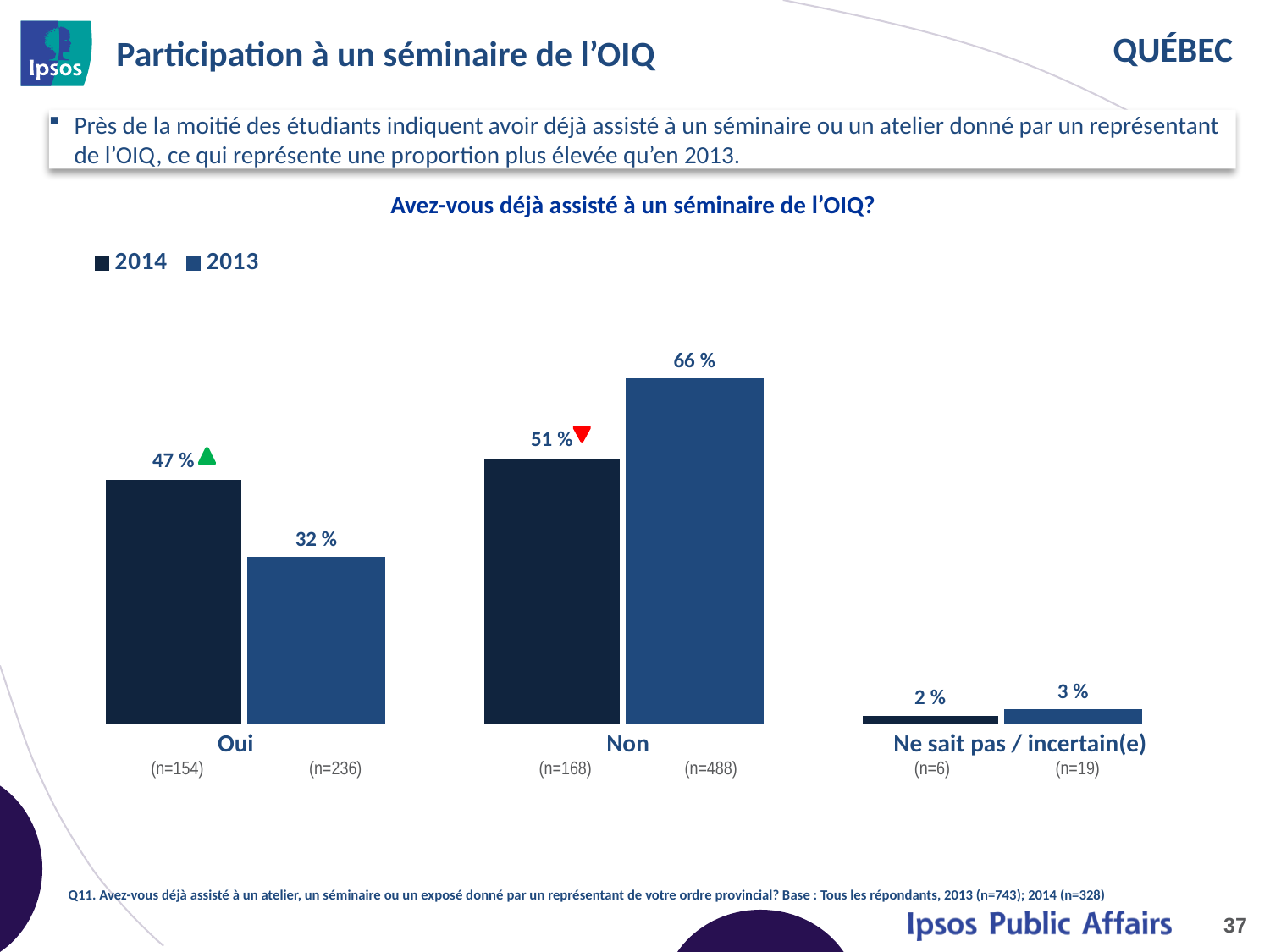
How many categories are shown on the x axis? 3 What is the value for "Ne sait pas / incertain(e)" in the 2014 series? 2 % What is the difference between the 2014 and 2013 values for "Oui"? 15 % How many series does the legend list? 2 Which category has the lowest value in the 2014 series? Ne sait pas / incertain(e) For "Non", which series has the larger value, 2014 or 2013? 2013 What is the value for "Non" in the 2013 series? 66 % What is the difference between the 2013 and 2014 values for "Non"? 15 % What kind of chart is shown on the slide? Bar chart What is the value for "Oui" in the 2014 series? 47 % What is the value for "Oui" in the 2013 series? 32 % Which category has the highest value in the 2013 series? Non